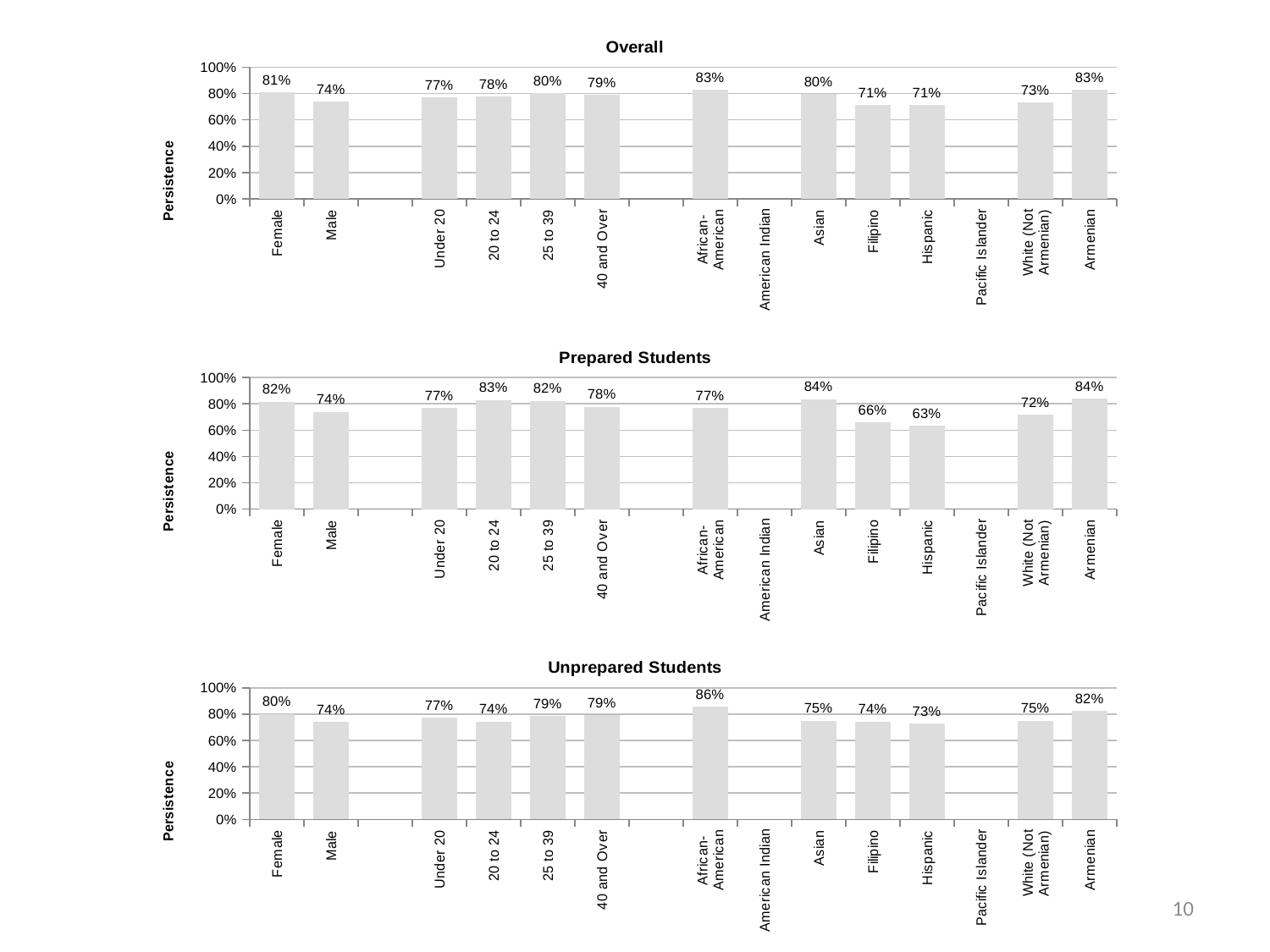
In the Unprepared Students chart, which category has the highest persistence? African-American In the Prepared Students chart, what is the persistence value for 20 to 24? 83% In the Overall chart, what is the persistence value for Hispanic? 71% In the Prepared Students chart, which category has the lowest persistence? Hispanic In the Overall chart, what is the persistence value for Female? 81% In the Prepared Students chart, what is the difference between the persistence for Asian and for Filipino? 18% What kind of chart is the Prepared Students chart? Bar chart What is the y-axis label of the Unprepared Students chart? Persistence In the Overall chart, what is the difference between the persistence for Female and for Male? 7% In the Unprepared Students chart, what is the persistence value for Armenian? 82% In the Unprepared Students chart, which is larger, the persistence for Female or for Male? Female How many category labels are shown on the x axis of the Overall chart? 14